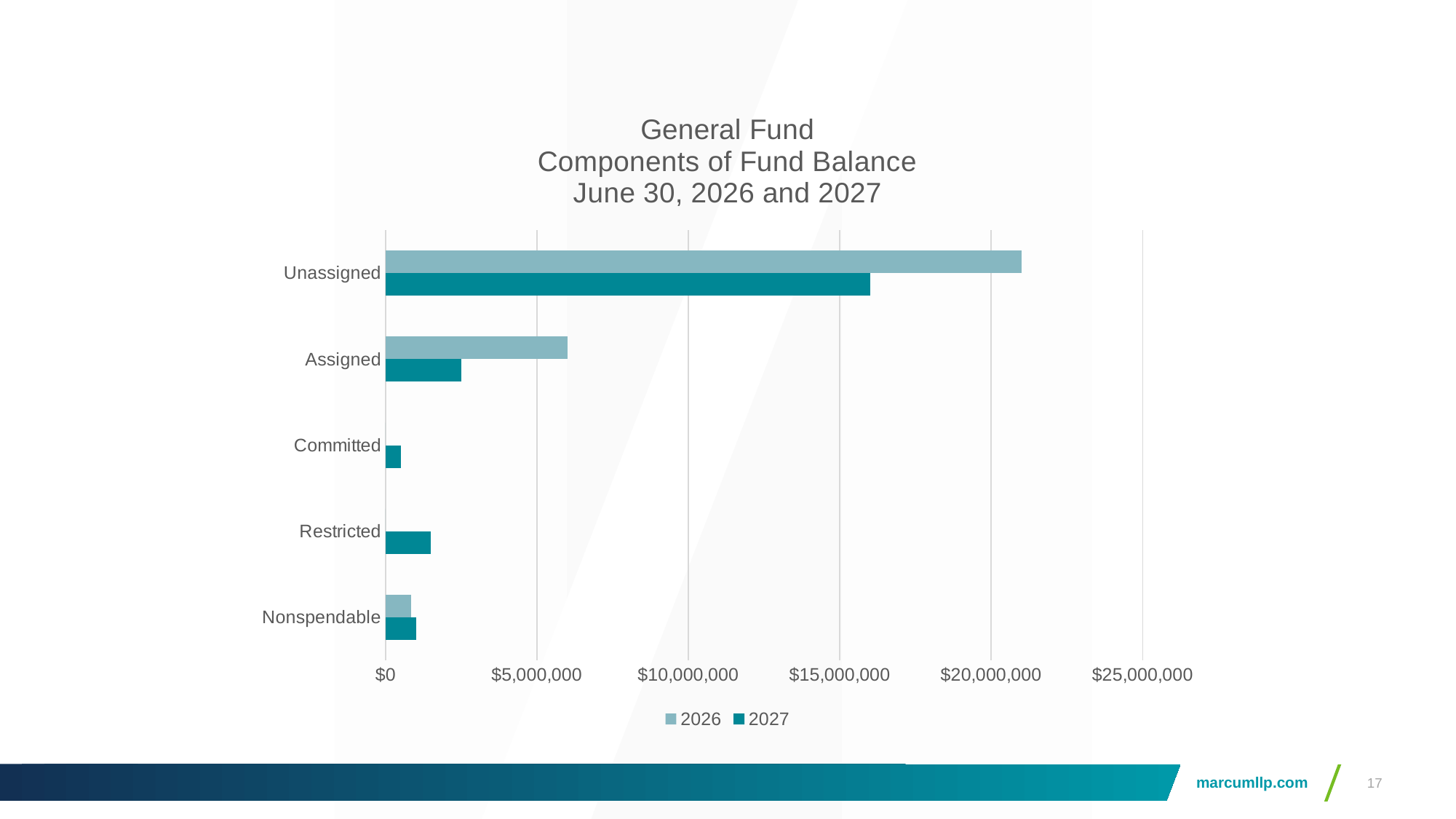
What kind of chart is shown on the slide? Bar chart What are the two years listed in the chart legend? 2026 and 2027 Which category has the highest value for 2026? Unassigned Which category has the lowest value for 2027? Committed For Assigned, which year has the larger value, 2026 or 2027? 2026 Which category has the highest value for 2027? Unassigned For Unassigned, which year has the larger value, 2026 or 2027? 2026 How many series does the legend list? 2 Is the 2027 value for Assigned greater or less than $5,000,000? less How many fund balance categories are plotted on the chart? 5 Is the 2026 value for Unassigned greater or less than $20,000,000? greater Is the 2027 value for Unassigned greater or less than $15,000,000? greater